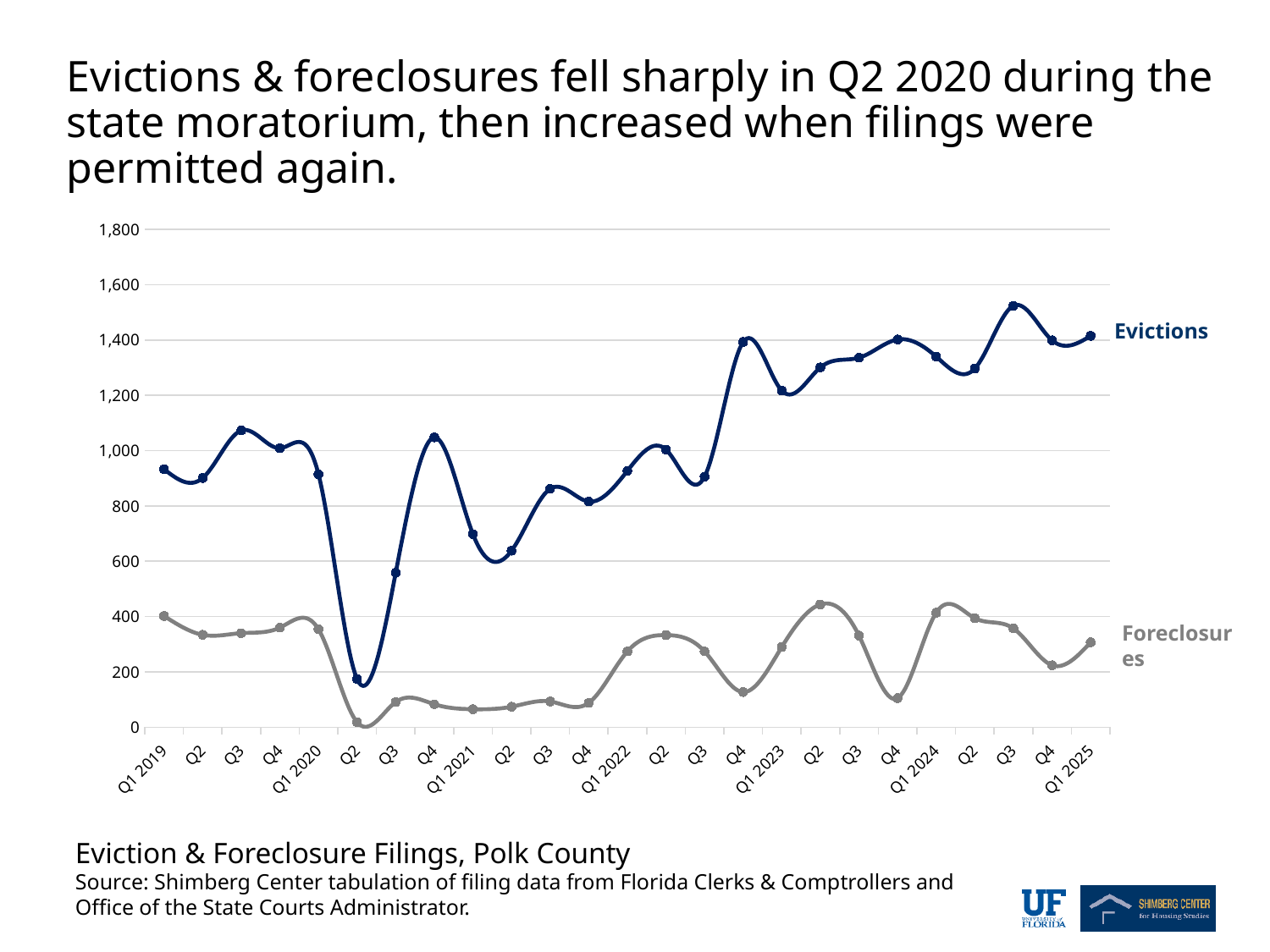
In which quarter does the Evictions line reach its highest value? Q3 2024 What kind of chart is shown on the slide? Line chart Is the value for Evictions in Q3 2024 greater or less than 1,400? greater How many series does the chart show? 2 In which quarter does the Evictions line reach its lowest value? Q2 2020 What are the names of the two series plotted on the chart? Evictions and Foreclosures In which quarter does the Foreclosures line reach its lowest value? Q2 2020 How many quarterly data points does each line have, from Q1 2019 to Q1 2025? 25 Which is larger in Q1 2025, Evictions or Foreclosures? Evictions What is the title of the chart, as given below it? Eviction & Foreclosure Filings, Polk County Is the value for Evictions in Q2 2020 greater or less than 400? less Do Evictions rise or fall between Q1 2020 and Q2 2020? Fall